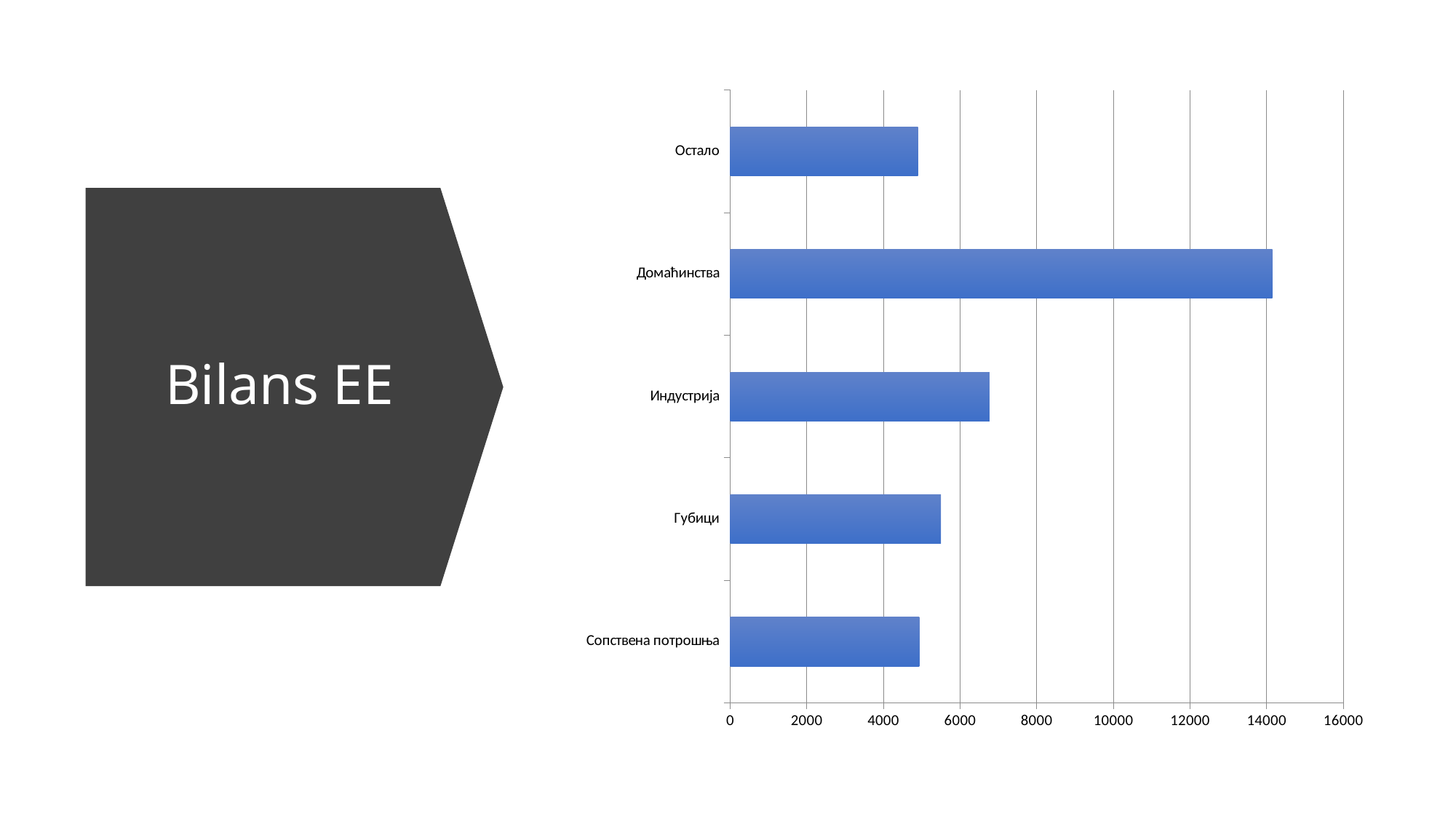
Is the value for Индустрија greater or less than 6000? greater Is the value for Остало greater or less than 4000? greater How many categories are plotted in the chart? 5 Is the value for Сопствена потрошња greater or less than 6000? less Which is larger, the value for Индустрија or the value for Губици? Индустрија What is the title text shown on the slide next to the chart? Bilans EE Which category has the highest value in the chart? Домаћинства Which is larger, the value for Домаћинства or the value for Индустрија? Домаћинства What kind of chart is shown on the slide? bar chart